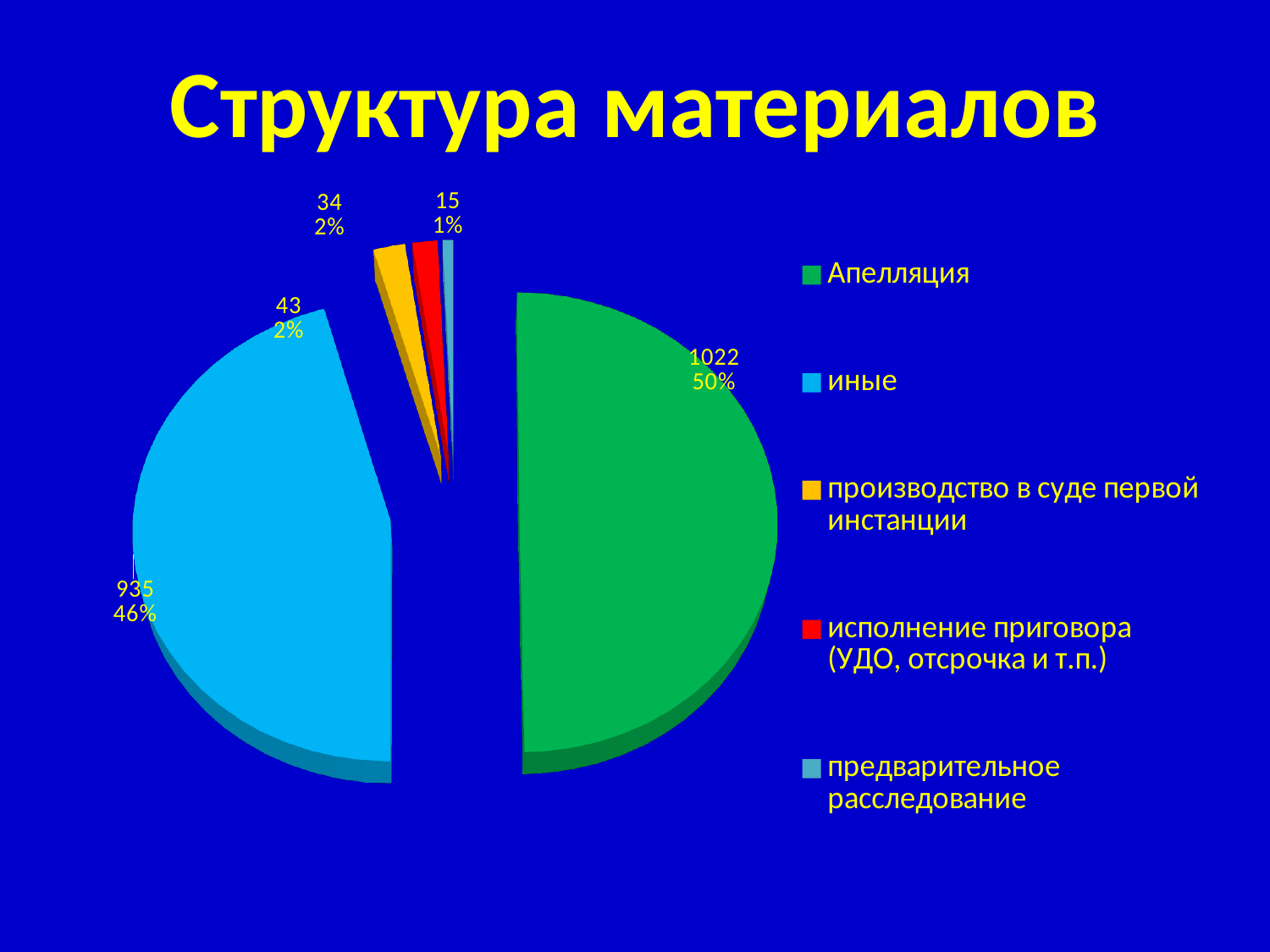
What is the value for производство в суде первой инстанции? 43 Which category has the largest slice of the pie? Апелляция What is the value for исполнение приговора (УДО, отсрочка и т.п.)? 34 What type of chart is shown on the slide? pie chart What share of the pie does иные represent? 46% Which is larger, the value for Апелляция or the value for иные? Апелляция How many categories does the legend list? 5 What is the value for иные? 935 What is the difference between the values for Апелляция and иные? 87 Which category has the smallest slice of the pie? предварительное расследование What is the value for Апелляция? 1022 What is the value for предварительное расследование? 15